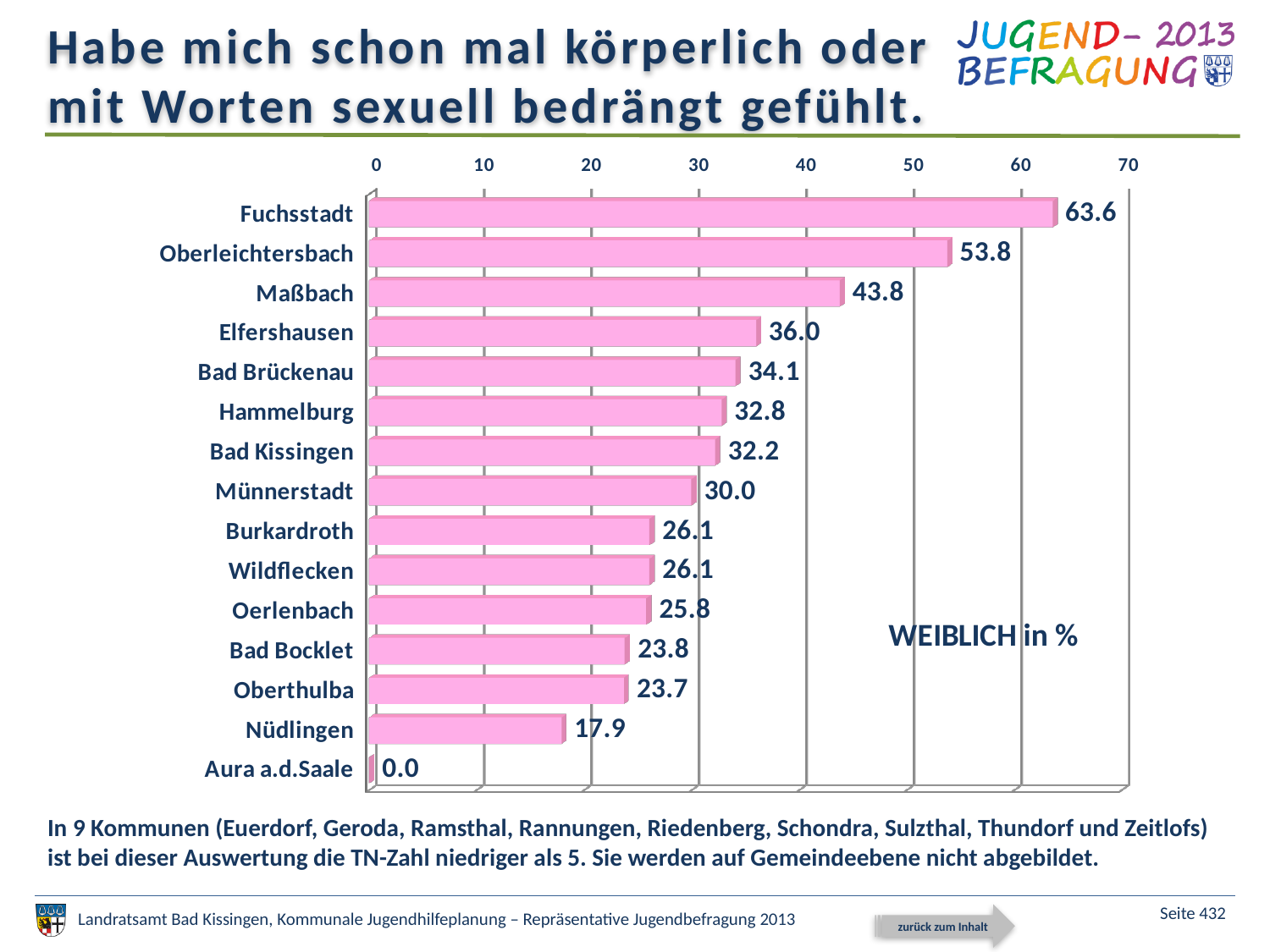
Is the value for Bad Brückenau greater or less than 30? greater Which municipality has the highest value? Fuchsstadt What kind of chart is shown on the slide? bar chart What is the value for Nüdlingen? 17.9 What label is shown inside the chart area describing the data? WEIBLICH in % Which municipality has the lowest value? Aura a.d.Saale What is the value for Fuchsstadt? 63.6 What is the value for Bad Kissingen? 32.2 What is the difference between the values for Fuchsstadt and Oberleichtersbach? 9.8 How many municipalities are shown in the chart? 15 What is the value for Hammelburg? 32.8 Which has a larger value, Maßbach or Elfershausen? Maßbach